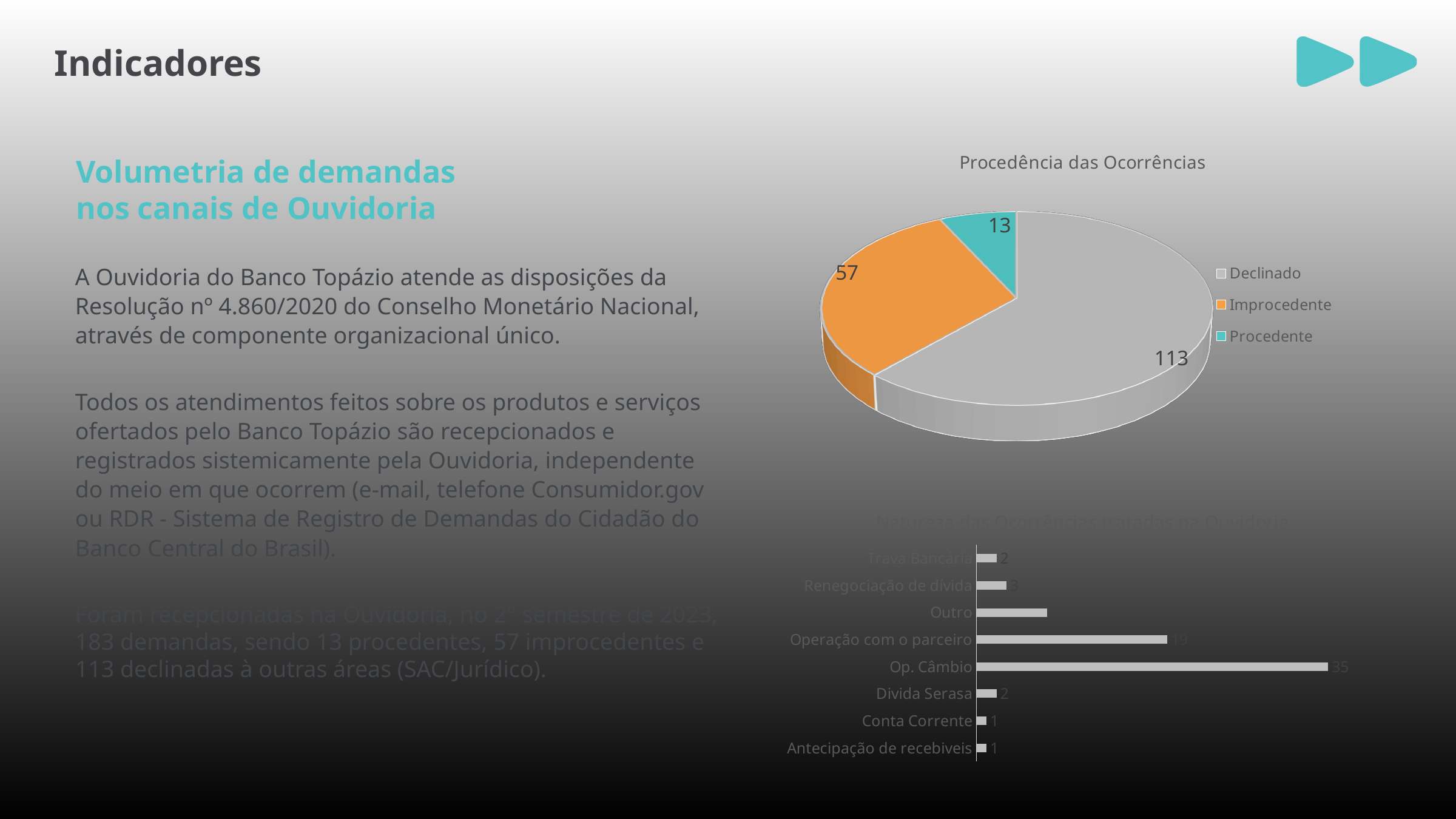
In the bar chart at the bottom right of the slide, which category has the longest bar? Op. Câmbio In the bar chart at the bottom right of the slide, what is the value for Op. Câmbio? 35 How many entries does the legend of the pie chart titled "Procedência das Ocorrências" list? 3 In the bar chart at the bottom right of the slide, what is the value for Operação com o parceiro? 19 In the pie chart titled "Procedência das Ocorrências", what is the value for Procedente? 13 In the pie chart titled "Procedência das Ocorrências", which category has the largest slice? Declinado In the pie chart titled "Procedência das Ocorrências", what is the value for Improcedente? 57 In the pie chart titled "Procedência das Ocorrências", what is the difference between the Declinado and Improcedente values? 56 In the pie chart titled "Procedência das Ocorrências", which category has the smallest slice? Procedente What type of chart is the chart titled "Procedência das Ocorrências"? Pie chart In the pie chart titled "Procedência das Ocorrências", what is the value for Declinado? 113 How many categories are shown in the bar chart at the bottom right of the slide? 8